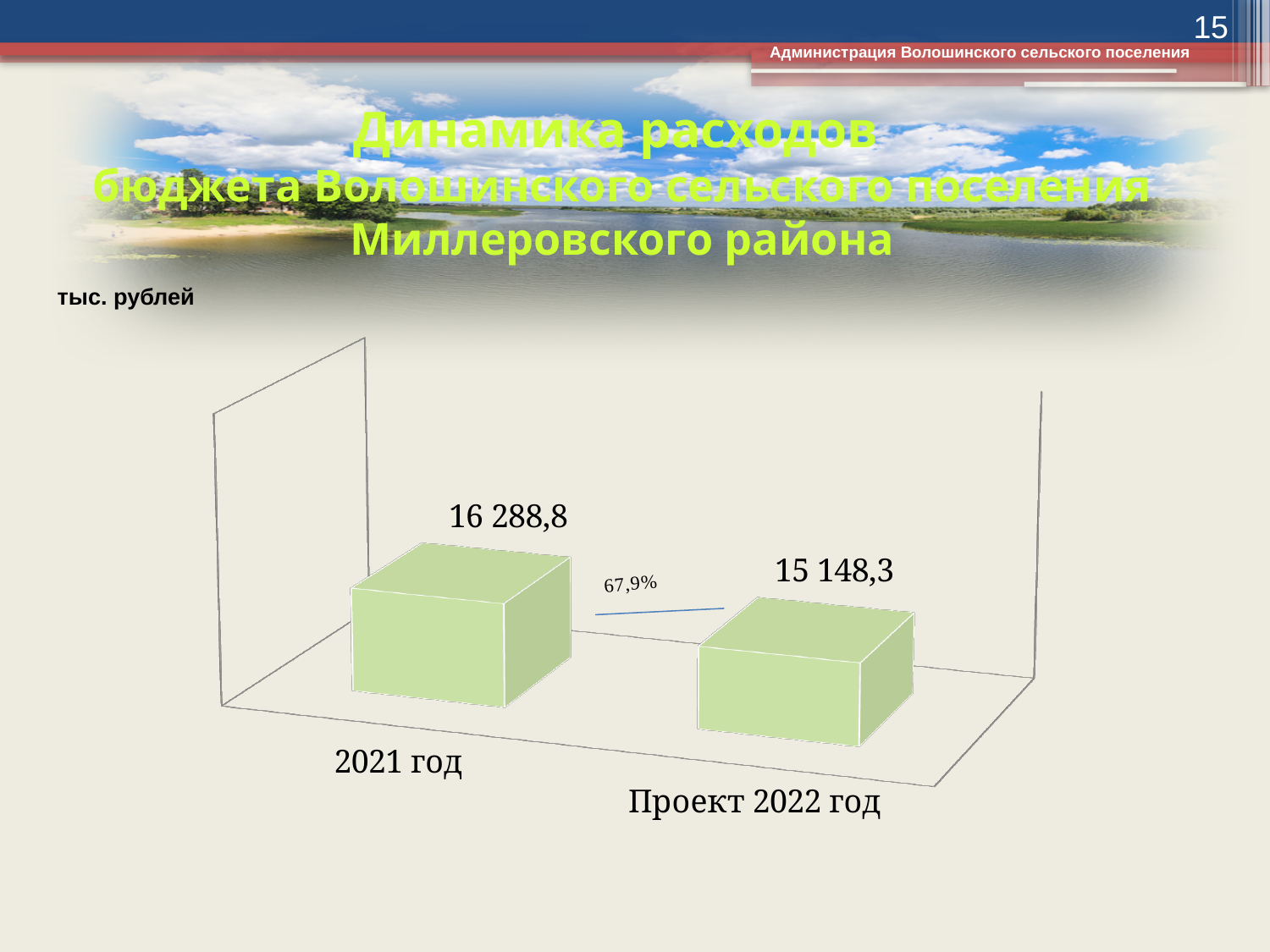
What kind of chart is shown on the slide? bar chart What is the value for Проект 2022 год? 15 148,3 Which category has the highest value? 2021 год What unit of measurement is stated for the chart? тыс. рублей Which category has the lowest value? Проект 2022 год How many categories are shown in the chart? 2 What is the difference between the values for 2021 год and Проект 2022 год? 1 140,5 Do the values rise or fall from 2021 год to Проект 2022 год? fall Which is larger, the value for 2021 год or the value for Проект 2022 год? 2021 год What is the value for 2021 год? 16 288,8 What percentage is printed on the line between the two bars? 67,9%